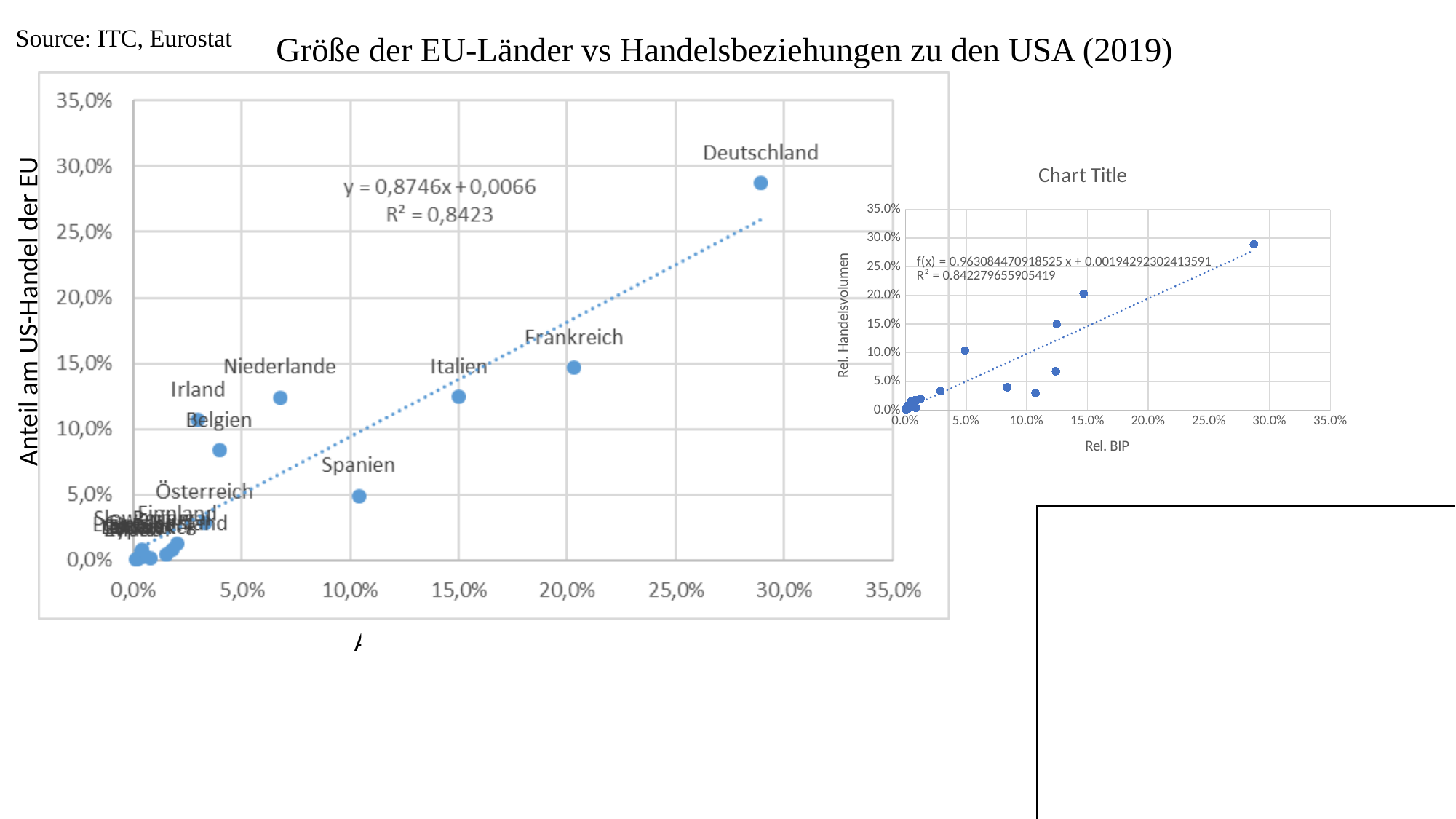
In the large chart "Größe der EU-Länder vs Handelsbeziehungen zu den USA (2019)", which has the higher share of EU-US trade, Niederlande or Spanien? Niederlande In the large chart "Größe der EU-Länder vs Handelsbeziehungen zu den USA (2019)", what is the trendline equation shown? y = 0,8746x + 0,0066 In the large chart "Größe der EU-Länder vs Handelsbeziehungen zu den USA (2019)", which has the higher share of EU-US trade, Frankreich or Italien? Frankreich In the small chart on the right titled "Chart Title", is the highest point on the vertical axis greater or less than 25.0%? greater In the large chart "Größe der EU-Länder vs Handelsbeziehungen zu den USA (2019)", is the value for Deutschland on the vertical axis greater or less than 25,0%? greater In the large chart "Größe der EU-Länder vs Handelsbeziehungen zu den USA (2019)", is the value for Frankreich on the vertical axis greater or less than 10,0%? greater In the large chart "Größe der EU-Länder vs Handelsbeziehungen zu den USA (2019)", which country has the highest share of EU-US trade? Deutschland What kind of chart is the large chart titled "Größe der EU-Länder vs Handelsbeziehungen zu den USA (2019)"? Scatter chart In the large chart "Größe der EU-Länder vs Handelsbeziehungen zu den USA (2019)", do the values generally rise or fall as you move right along the x axis? Rise What is the title of the small chart on the right of the slide? Chart Title